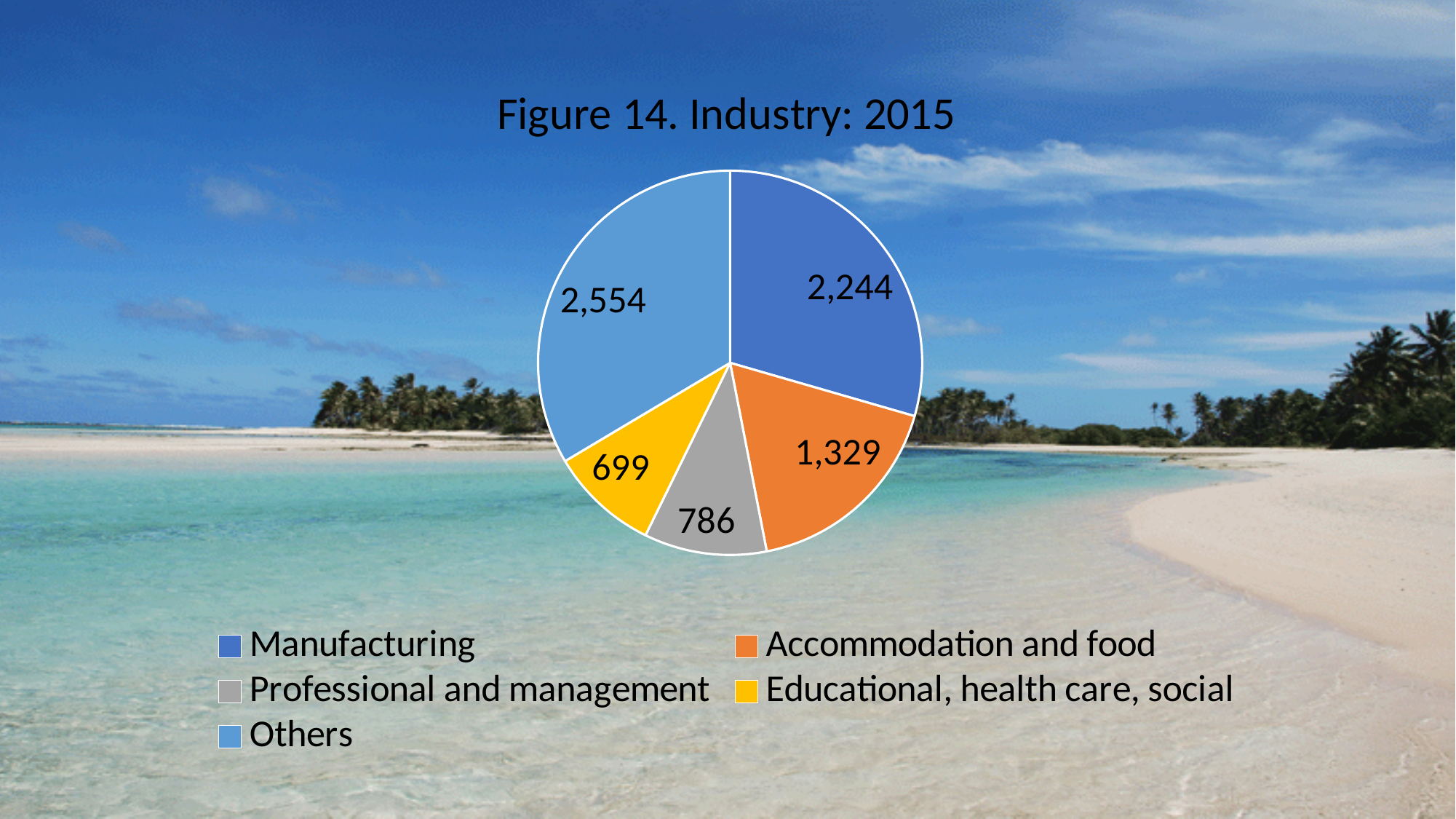
Which is larger, Accommodation and food or Professional and management? Accommodation and food What is the value for Others? 2,554 What kind of chart is shown on the slide? Pie chart What is the value for Accommodation and food? 1,329 What is the value for Professional and management? 786 What is the title of the chart? Figure 14. Industry: 2015 Which category has the largest slice? Others What is the value for Manufacturing? 2,244 What is the value for Educational, health care, social? 699 How many categories does the pie chart show? 5 What is the difference between the values for Others and Manufacturing? 310 Which category has the smallest slice? Educational, health care, social